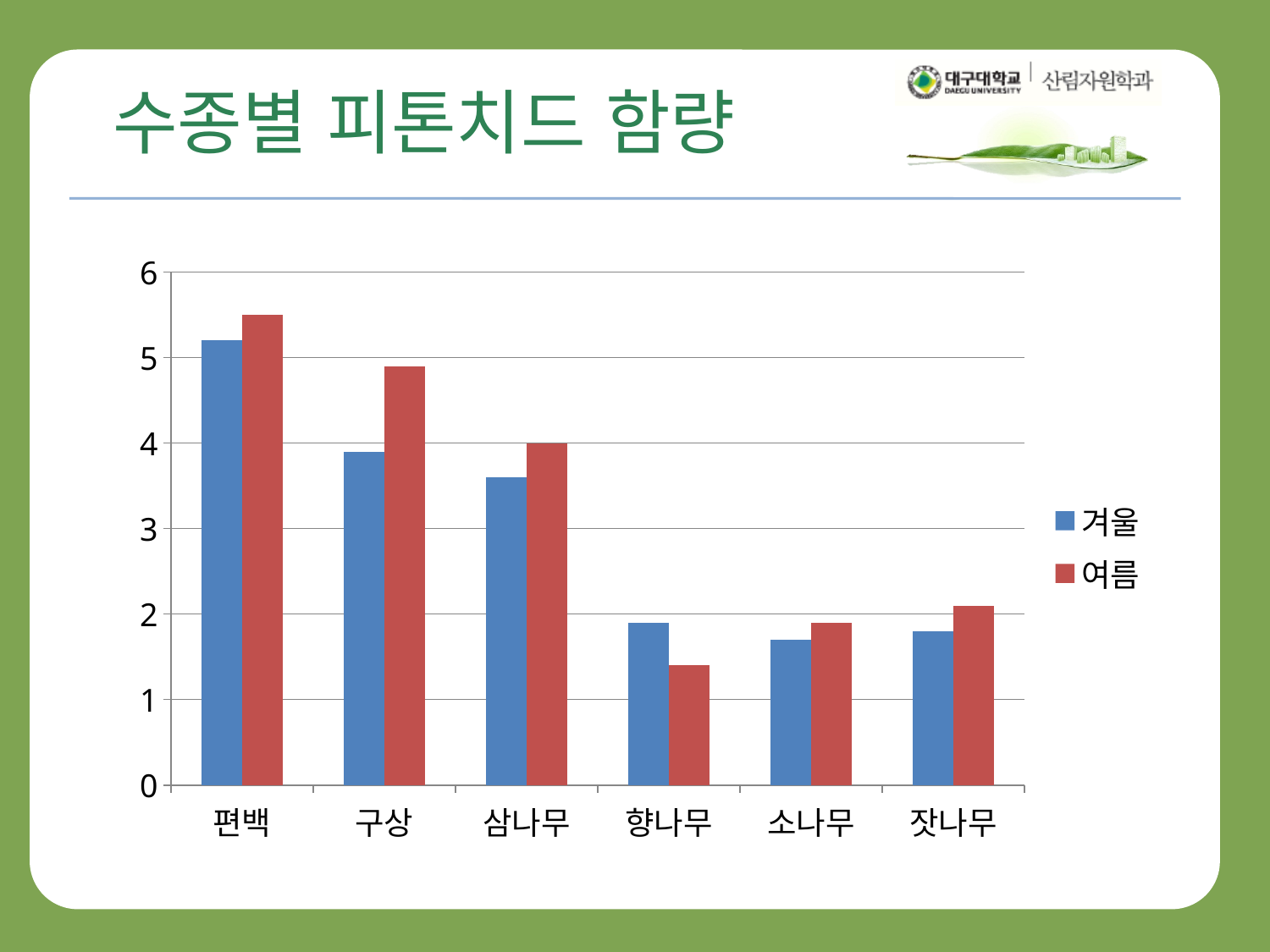
What are the two series named in the legend? 겨울, 여름 What is the title of the slide containing the chart? 수종별 피톤치드 함량 Is the 여름 value for 향나무 greater or less than 2? less Is the 겨울 value for 편백 greater or less than 5? greater How many tree species (categories) are shown on the x axis? 6 Which species has the highest 겨울 value? 편백 Which species has the highest 여름 value? 편백 What kind of chart is shown on the slide? bar chart For 향나무, which is larger: the 겨울 value or the 여름 value? 겨울 Which species has the lowest 여름 value? 향나무 For 겨울, which is larger: 편백 or 구상? 편백 How many series does the legend list? 2